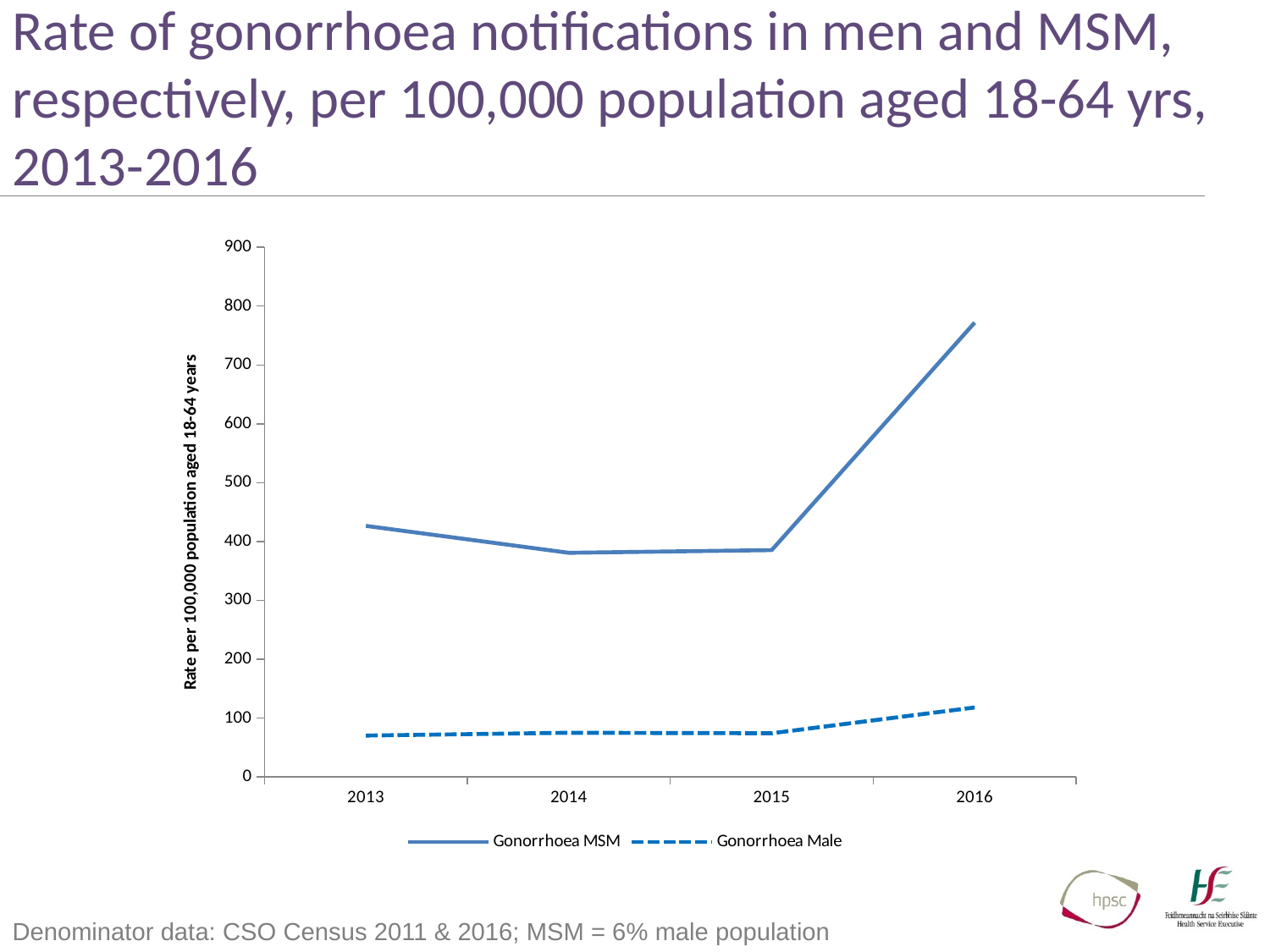
In which year is the Gonorrhoea MSM rate highest? 2016 Is the Gonorrhoea Male value for 2016 greater or less than 100? greater Which series has the higher value in 2015, Gonorrhoea MSM or Gonorrhoea Male? Gonorrhoea MSM Does the Gonorrhoea MSM rate rise or fall from 2015 to 2016? Rise How many series does the legend list? 2 In which year is the Gonorrhoea Male rate highest? 2016 Which series is drawn with a dashed line? Gonorrhoea Male Is the Gonorrhoea MSM value for 2016 greater or less than 700? greater Is the Gonorrhoea MSM value for 2014 greater or less than 400? less How many years are plotted along the x axis? 4 What kind of chart is shown on the slide? Line chart